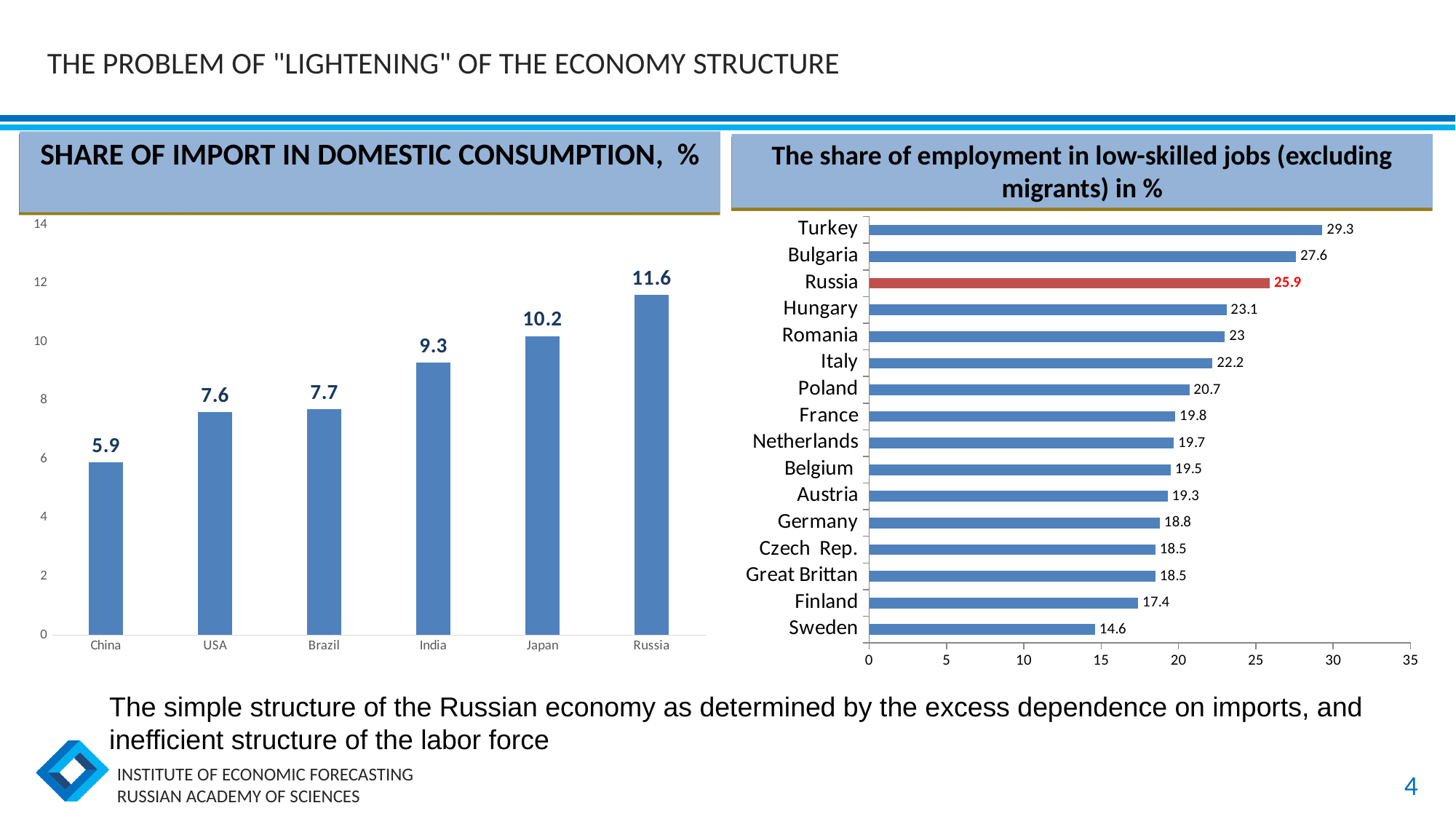
In the 'Share of import in domestic consumption, %' chart, what is the difference between Russia and China? 5.7 In the chart on the right, 'The share of employment in low-skilled jobs (excluding migrants) in %', which country has the lowest value? Sweden In the 'Share of import in domestic consumption, %' chart, which country has the lowest value? China In the chart on the right, 'The share of employment in low-skilled jobs (excluding migrants) in %', what is the value for Russia? 25.9 In the chart on the right, 'The share of employment in low-skilled jobs (excluding migrants) in %', what is the difference between Turkey and Sweden? 14.7 In the 'Share of import in domestic consumption, %' chart, what is the value for India? 9.3 In the chart on the right, 'The share of employment in low-skilled jobs (excluding migrants) in %', how many countries are listed? 16 In the 'Share of import in domestic consumption, %' chart, how many countries are shown? 6 In the 'Share of import in domestic consumption, %' chart, which country has the highest value? Russia In the chart on the right, 'The share of employment in low-skilled jobs (excluding migrants) in %', which country has the highest value? Turkey In the 'Share of import in domestic consumption, %' chart, do the values rise or fall from China to Russia? rise In the chart on the right, 'The share of employment in low-skilled jobs (excluding migrants) in %', which country's bar is coloured red? Russia